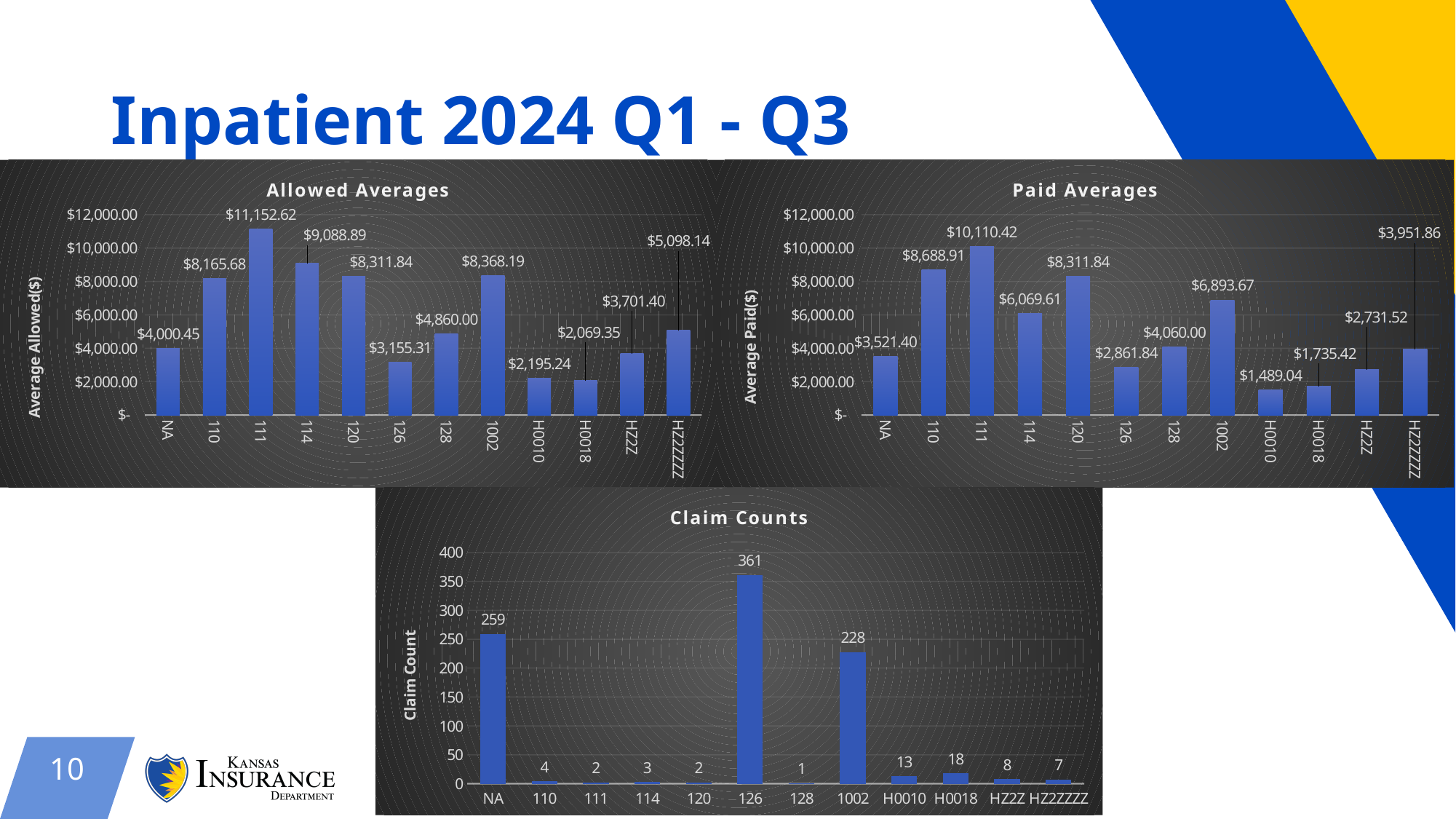
What type of chart is the Paid Averages chart? bar chart In the Paid Averages chart, which is larger, the value for 110 or the value for 120? 110 In the Paid Averages chart, which category has the lowest value? H0010 What is the y-axis label of the Allowed Averages chart? Average Allowed($) In the Claim Counts chart, which category has the highest claim count? 126 In the Claim Counts chart, how many more claims does 126 have than NA? 102 In the Allowed Averages chart, what is the value for category 111? $11,152.62 In the Allowed Averages chart, what is the difference between the values for 111 and 114? $2,063.73 In the Paid Averages chart, what is the value for category 1002? $6,893.67 In the Claim Counts chart, what is the claim count for H0018? 18 How many categories are shown on the x axis of the Claim Counts chart? 12 In the Allowed Averages chart, is the value for 128 greater or less than $4,000.00? greater